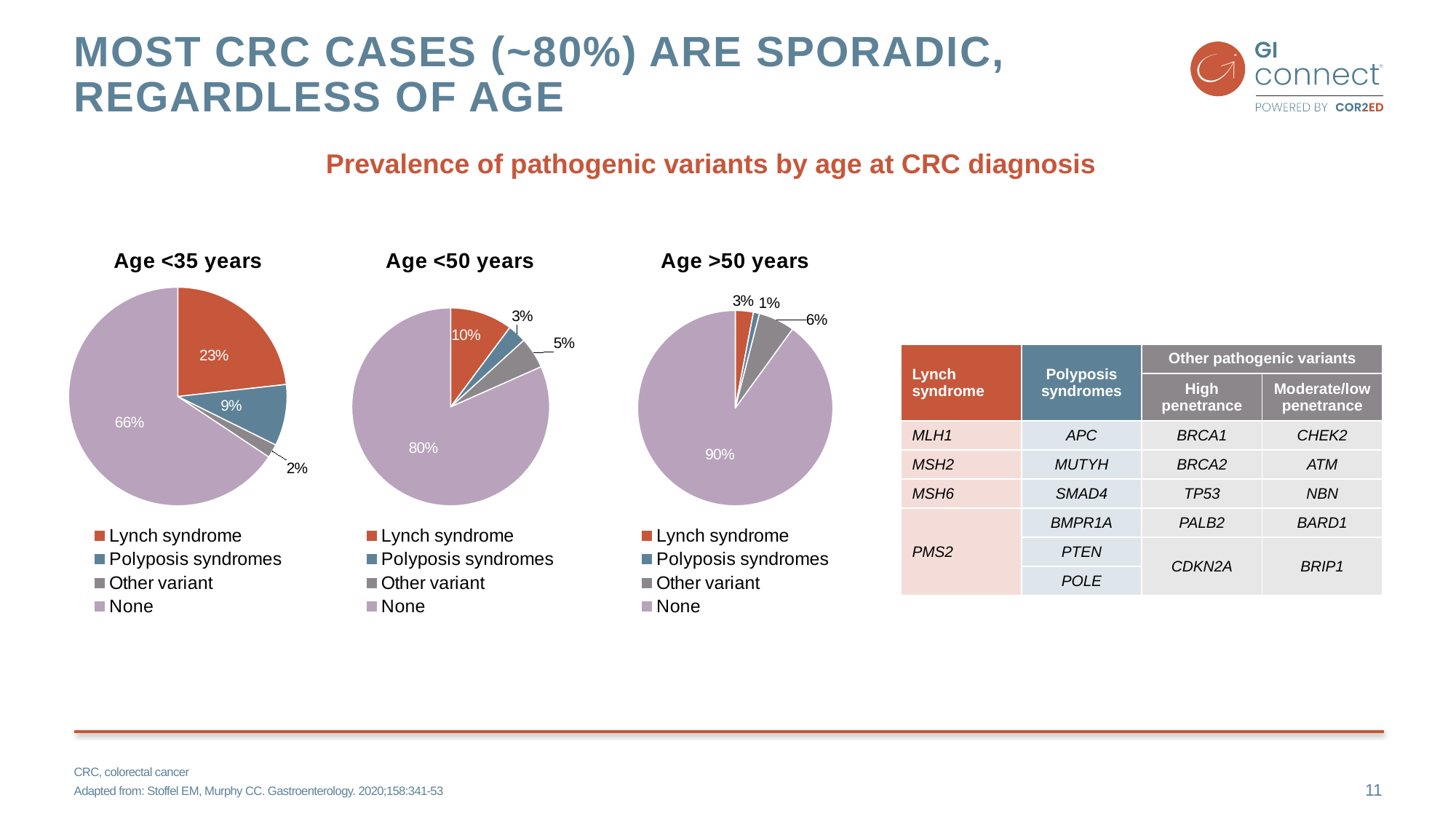
What is the difference between the Lynch syndrome percentage in the 'Age <35 years' chart and in the 'Age >50 years' chart? 20% In the 'Age <50 years' chart, what percentage is shown for None? 80% In the 'Age <35 years' chart, which category has the largest slice? None In the 'Age <50 years' chart, which is larger: Other variant or Polyposis syndromes? Other variant In the 'Age >50 years' chart, which category has the smallest slice? Polyposis syndromes How many categories does the legend of the 'Age >50 years' chart list? 4 In the 'Age <35 years' chart, what percentage is shown for Polyposis syndromes? 9% What type of chart is used for 'Age <50 years'? Pie chart In the 'Age >50 years' chart, what percentage is shown for Other variant? 6% What is the title shown above the three pie charts? Prevalence of pathogenic variants by age at CRC diagnosis In the 'Age <35 years' chart, what percentage is shown for Lynch syndrome? 23% How many pie charts are shown on the slide? 3